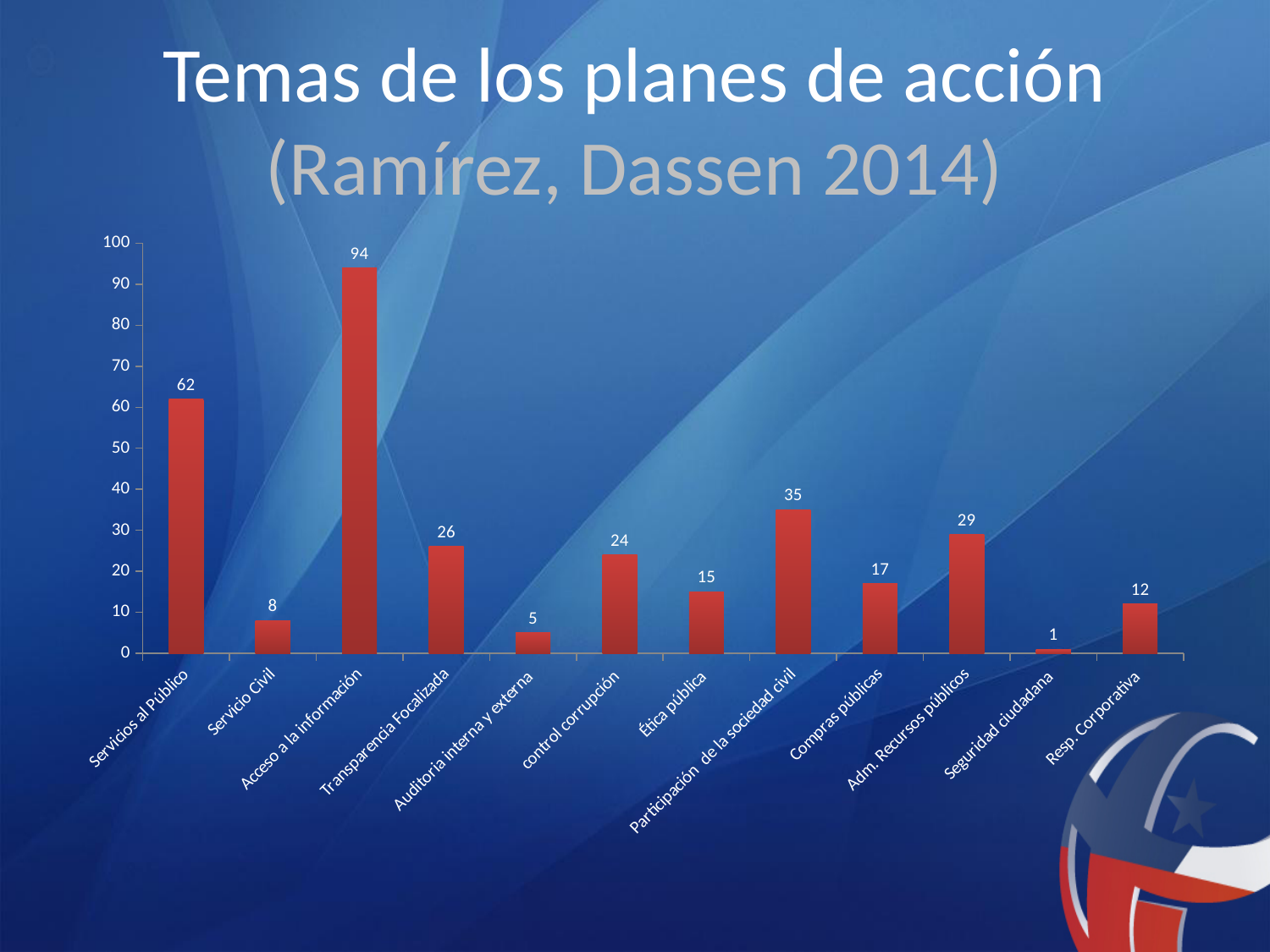
What is the title of the chart on the slide? Temas de los planes de acción (Ramírez, Dassen 2014) What is the value for Participación de la sociedad civil? 35 How many categories are shown on the x axis? 12 Which is larger, the value for Adm. Recursos públicos or the value for Transparencia Focalizada? Adm. Recursos públicos What is the difference between the values for Acceso a la información and Servicios al Público? 32 What is the difference between the values for Compras públicas and Ética pública? 2 What is the value for Acceso a la información? 94 Is the value for Servicios al Público greater or less than 50? greater Which category has the highest value? Acceso a la información What is the value for Seguridad ciudadana? 1 Which category has the lowest value? Seguridad ciudadana What kind of chart is shown on the slide? bar chart